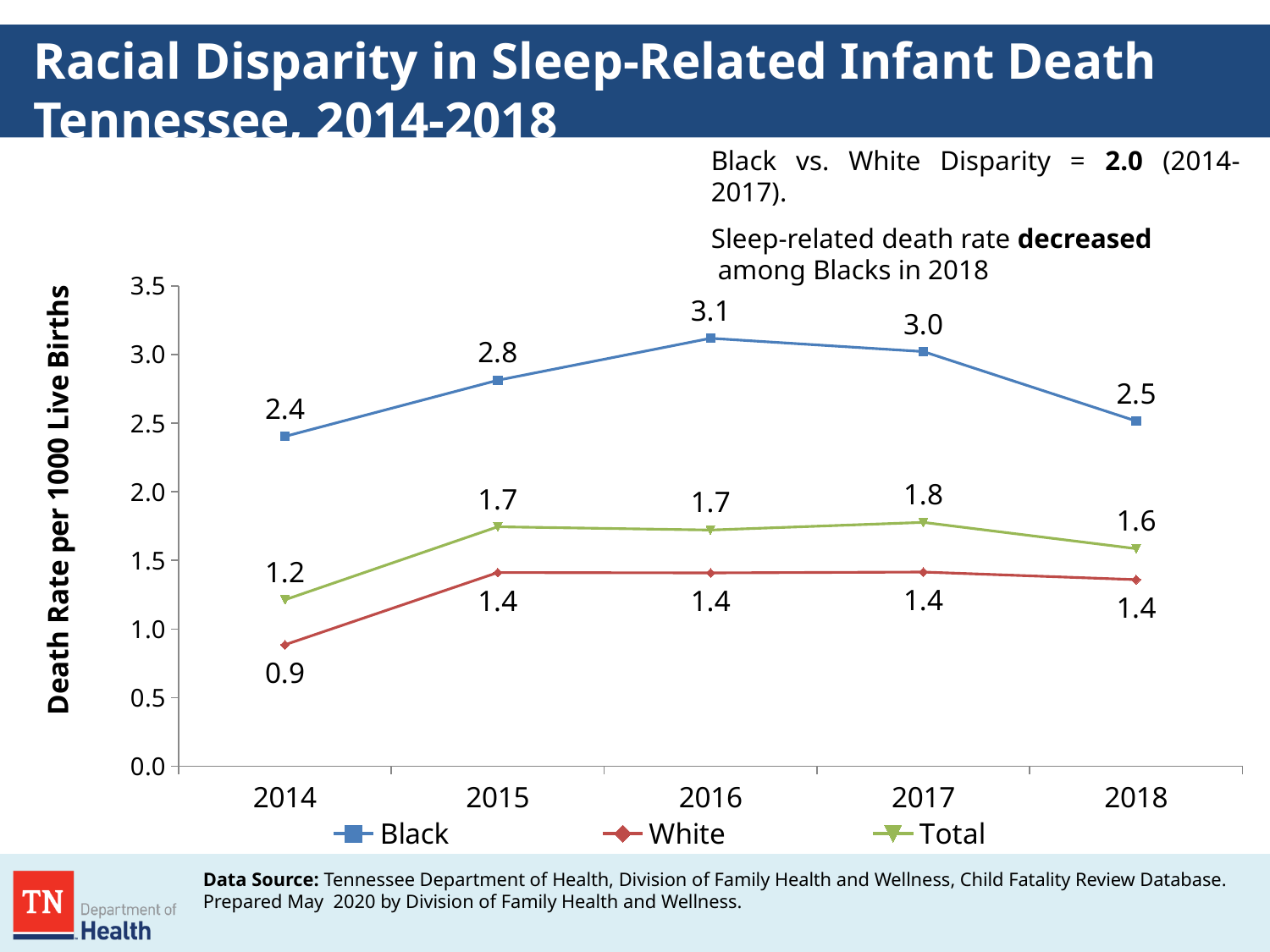
Is the Black death rate in 2017 greater or less than 2.5? greater What kind of chart is shown on the slide? line chart What is the death rate for White infants in 2014? 0.9 Which series has the higher value in 2015, Black or Total? Black In which year is the Total death rate lowest? 2014 In which year is the Black death rate highest? 2016 Does the Black death rate rise or fall from 2017 to 2018? fall What is the difference between the Black and White death rates in 2018? 1.1 What is the Total death rate in 2017? 1.8 How many years are shown on the x axis? 5 How many series does the legend list? 3 What is the death rate for Black infants in 2016? 3.1